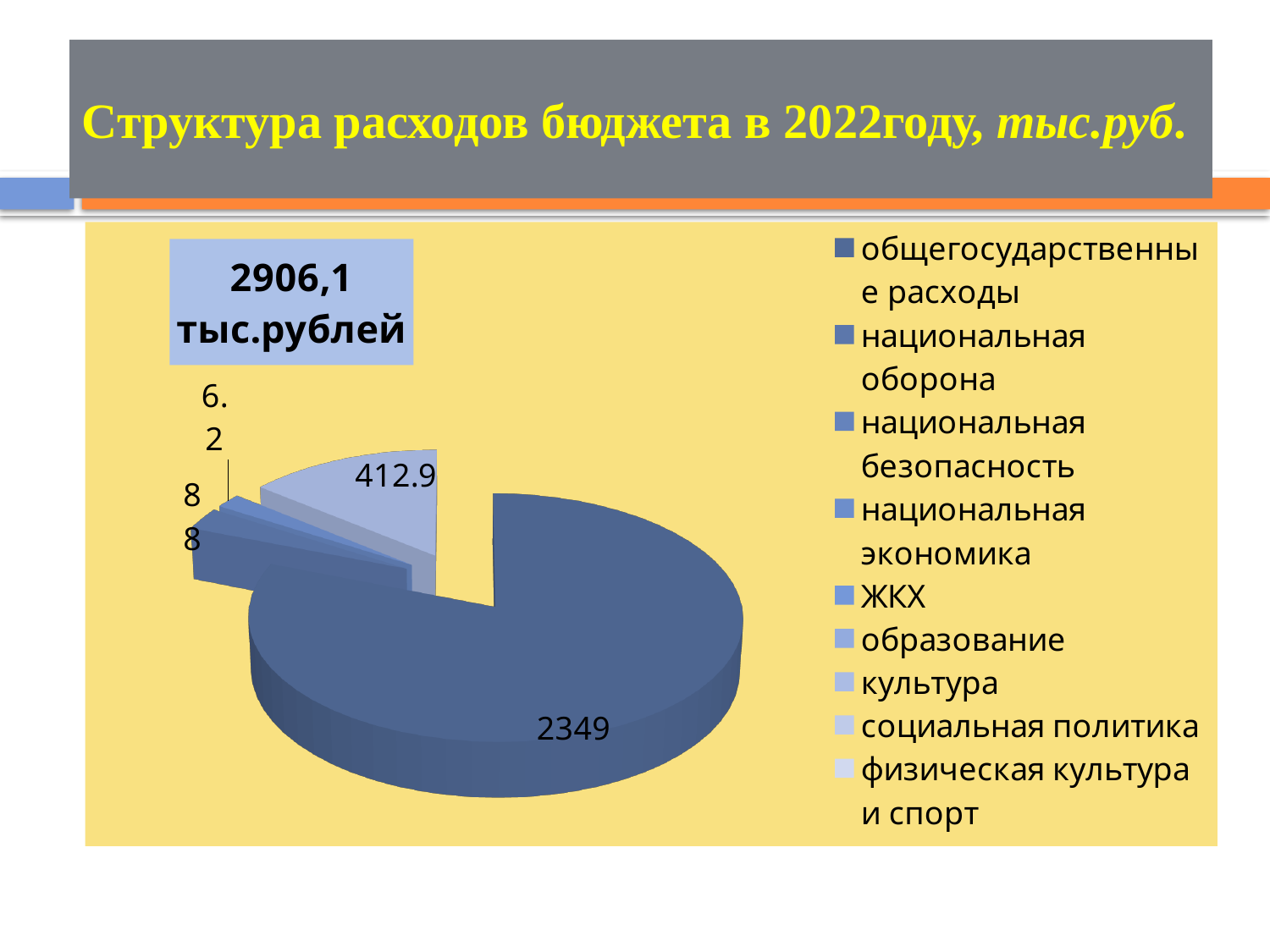
What is the value of the largest slice of the pie chart? 2349 What total amount is shown in the text box on the chart? 2906,1 тыс.рублей What is the title of the slide containing the pie chart? Структура расходов бюджета в 2022году, тыс.руб. What is the difference between the slice labelled 2349 and the slice labelled 412.9? 1936.1 Which category has the largest slice in the pie chart? общегосударственные расходы What is the value shown for общегосударственные расходы in the pie chart? 2349 How many categories does the legend of the pie chart list? 9 Which is larger: the slice labelled 2349 or the slice labelled 412.9? 2349 What kind of chart is shown on the slide? pie chart